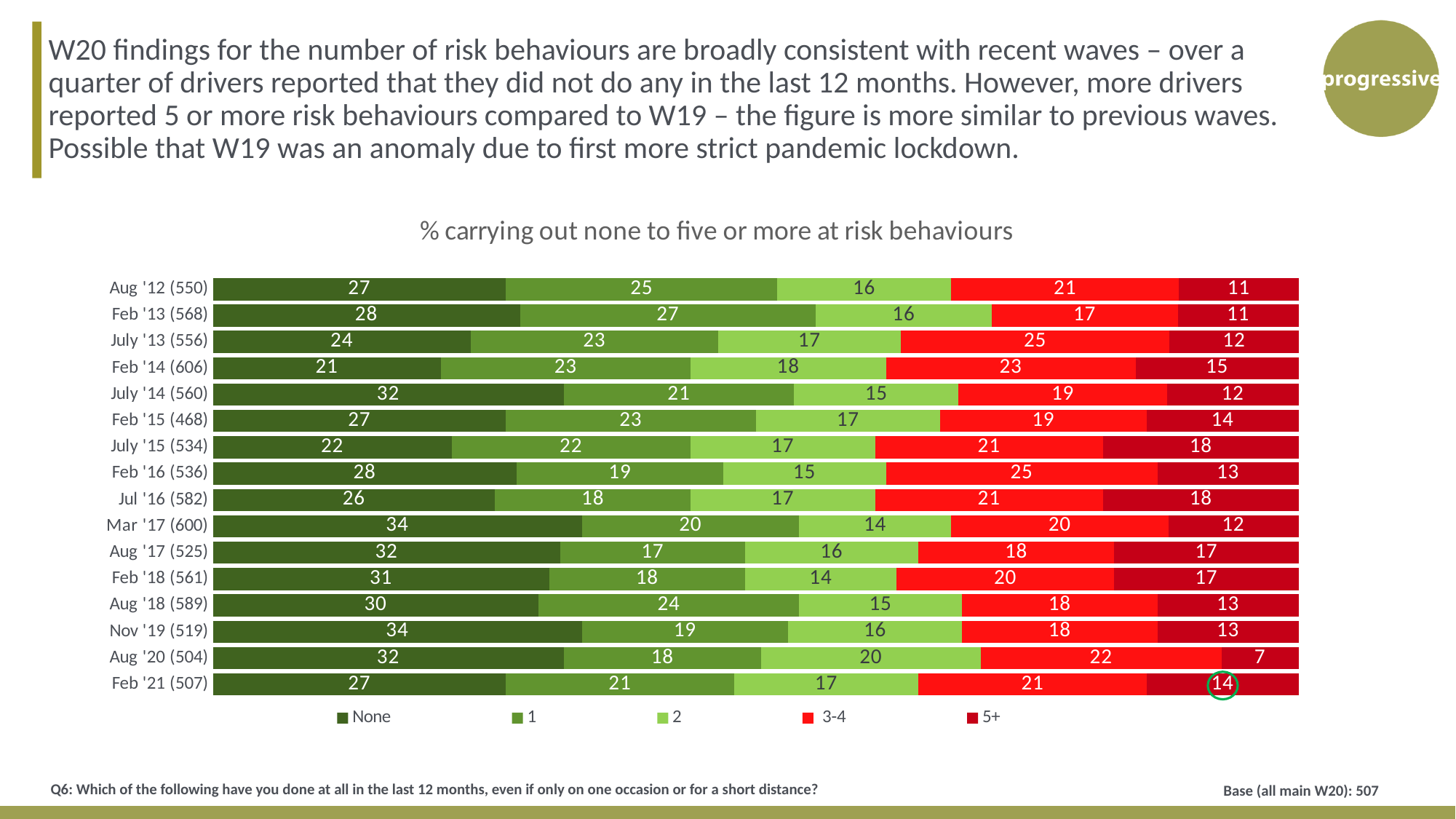
How many waves (categories) are plotted in the chart? 16 Which is larger: the 'None' value for Mar '17 (600) or for Feb '21 (507)? Mar '17 (600) What is the difference between the '5+' value for Feb '21 (507) and Aug '20 (504)? 7 What is the value for '5+' in the Aug '20 (504) wave? 7 Which wave has the highest value for '2'? Aug '20 (504) What is the value for 'None' in the Feb '21 (507) wave? 27 Which wave has the lowest value for '5+'? Aug '20 (504) What is the title of the chart? % carrying out none to five or more at risk behaviours How many series does the legend list? 5 Which wave has the lowest value for 'None'? Feb '14 (606) What is the value for '3-4' in the July '13 (556) wave? 25 What kind of chart is shown on the slide? Stacked bar chart